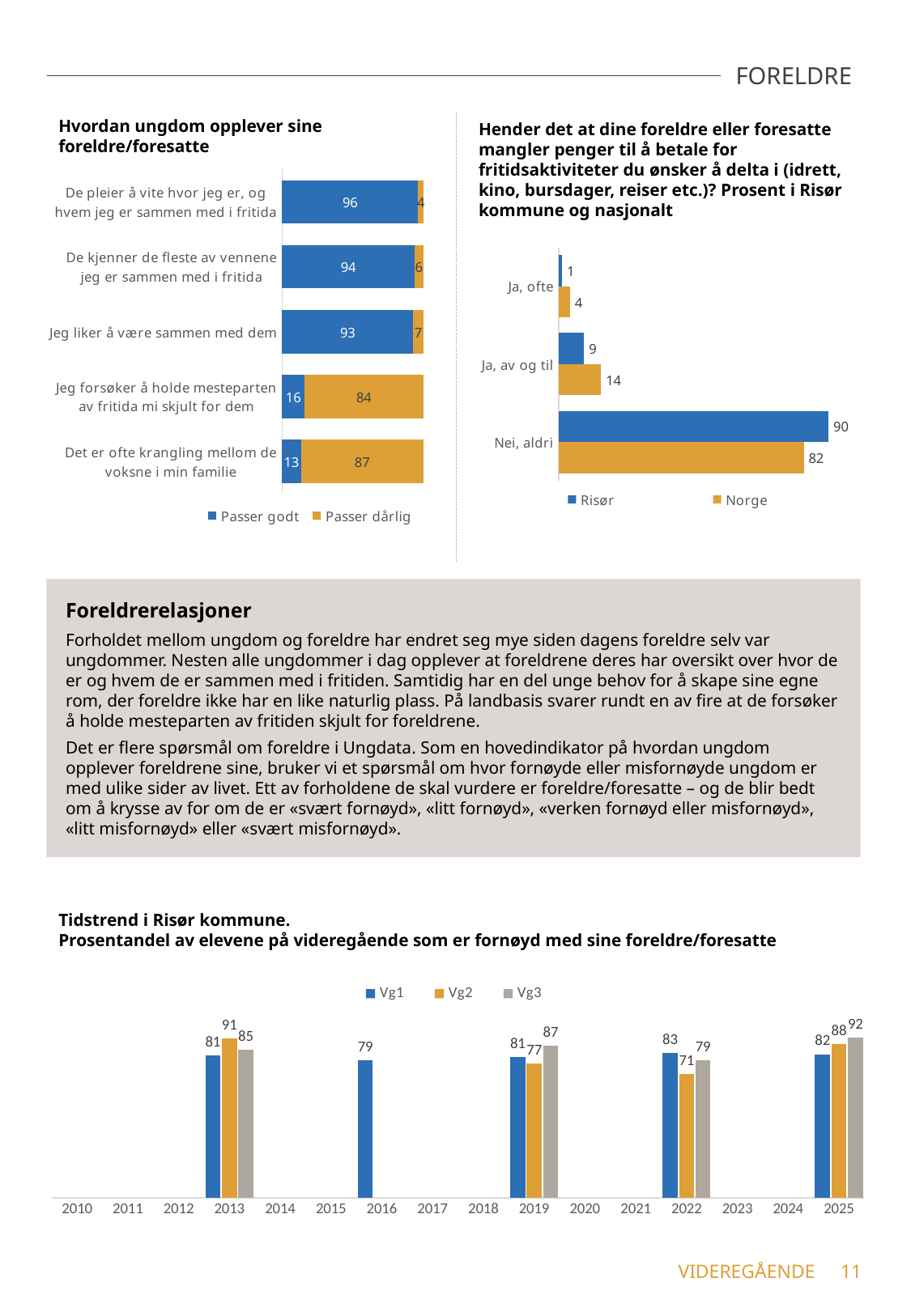
In the chart 'Hvordan ungdom opplever sine foreldre/foresatte', what is the 'Passer godt' value for 'De pleier å vite hvor jeg er, og hvem jeg er sammen med i fritida'? 96 In the chart 'Hender det at dine foreldre eller foresatte mangler penger...', what is the Norge value for 'Ja, av og til'? 14 In the chart 'Hvordan ungdom opplever sine foreldre/foresatte', which statement has the lowest 'Passer godt' value? Det er ofte krangling mellom de voksne i min familie In the chart 'Hvordan ungdom opplever sine foreldre/foresatte', how many statements (categories) are shown? 5 In the chart 'Hvordan ungdom opplever sine foreldre/foresatte', what is the total of the stacked bar for 'Jeg forsøker å holde mesteparten av fritida mi skjult for dem'? 100 In the chart 'Tidstrend i Risør kommune', what is the Vg3 value for 2025? 92 What type of chart is 'Tidstrend i Risør kommune'? Bar chart In the chart 'Hender det at dine foreldre eller foresatte mangler penger...', which is larger for 'Ja, ofte': Risør or Norge? Norge In the chart 'Hvordan ungdom opplever sine foreldre/foresatte', what is the 'Passer dårlig' value for 'Det er ofte krangling mellom de voksne i min familie'? 87 In the chart 'Hender det at dine foreldre eller foresatte mangler penger...', how many series does the legend list? 2 In the chart 'Tidstrend i Risør kommune', which year has the lowest Vg2 value? 2022 In the chart 'Hender det at dine foreldre eller foresatte mangler penger...', what is the difference between Risør and Norge for 'Nei, aldri'? 8